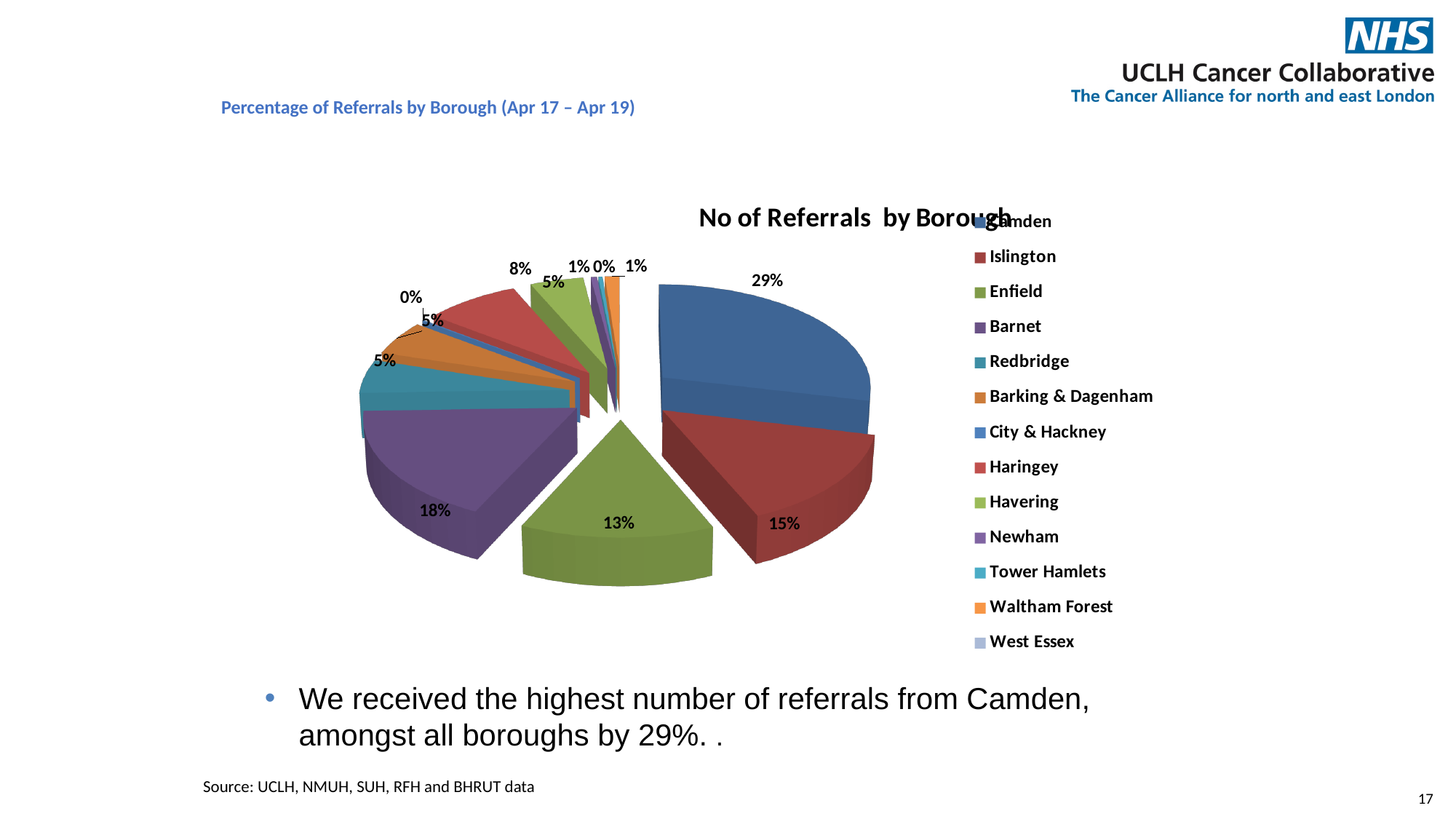
What percentage of referrals came from Camden? 29% How many boroughs are listed in the chart legend? 13 What percentage of referrals came from Barnet? 18% Which borough is listed last in the legend? West Essex What kind of chart is shown on the slide? Pie chart What percentage of referrals came from Islington? 15% What is the difference in percentage points between Camden's share and Barnet's share? 11 percentage points What percentage of referrals came from Enfield? 13% What is the title of the chart? No of Referrals by Borough What percentage of referrals came from Haringey? 8% Which has a larger share of referrals, Islington or Enfield? Islington Which borough has the largest share of referrals? Camden